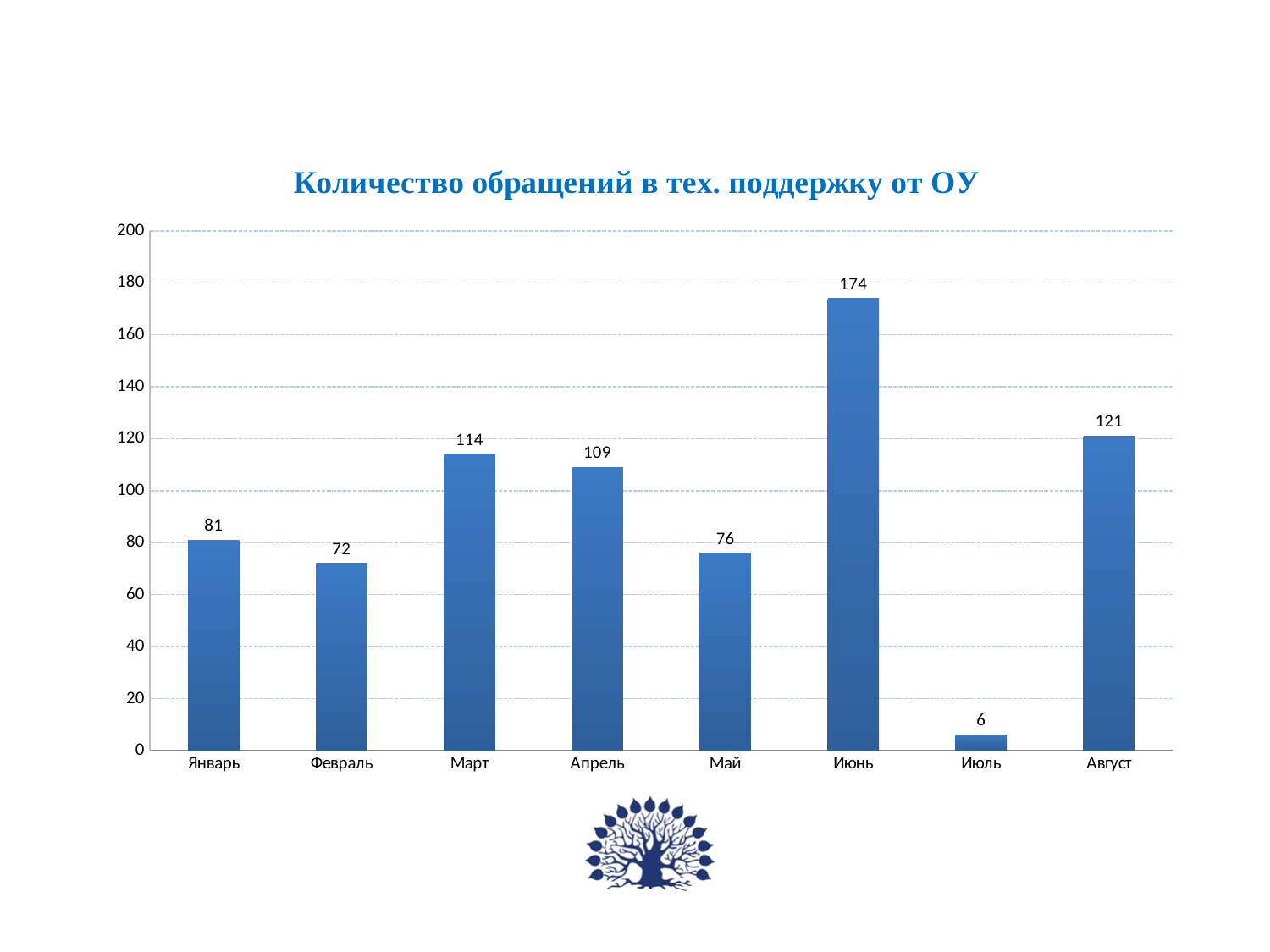
What is the value for Июль? 6 What is the value for Март? 114 What is the difference between the values for Январь and Февраль? 9 What is the title of the chart? Количество обращений в тех. поддержку от ОУ Which month has the lowest value? Июль What is the value for Август? 121 How many months are shown on the x axis? 8 What kind of chart is shown on the slide? bar chart Is the value for Май greater or less than 100? less Which is larger, the value for Март or the value for Апрель? Март Which month has the highest value? Июнь What is the difference between the values for Июнь and Август? 53